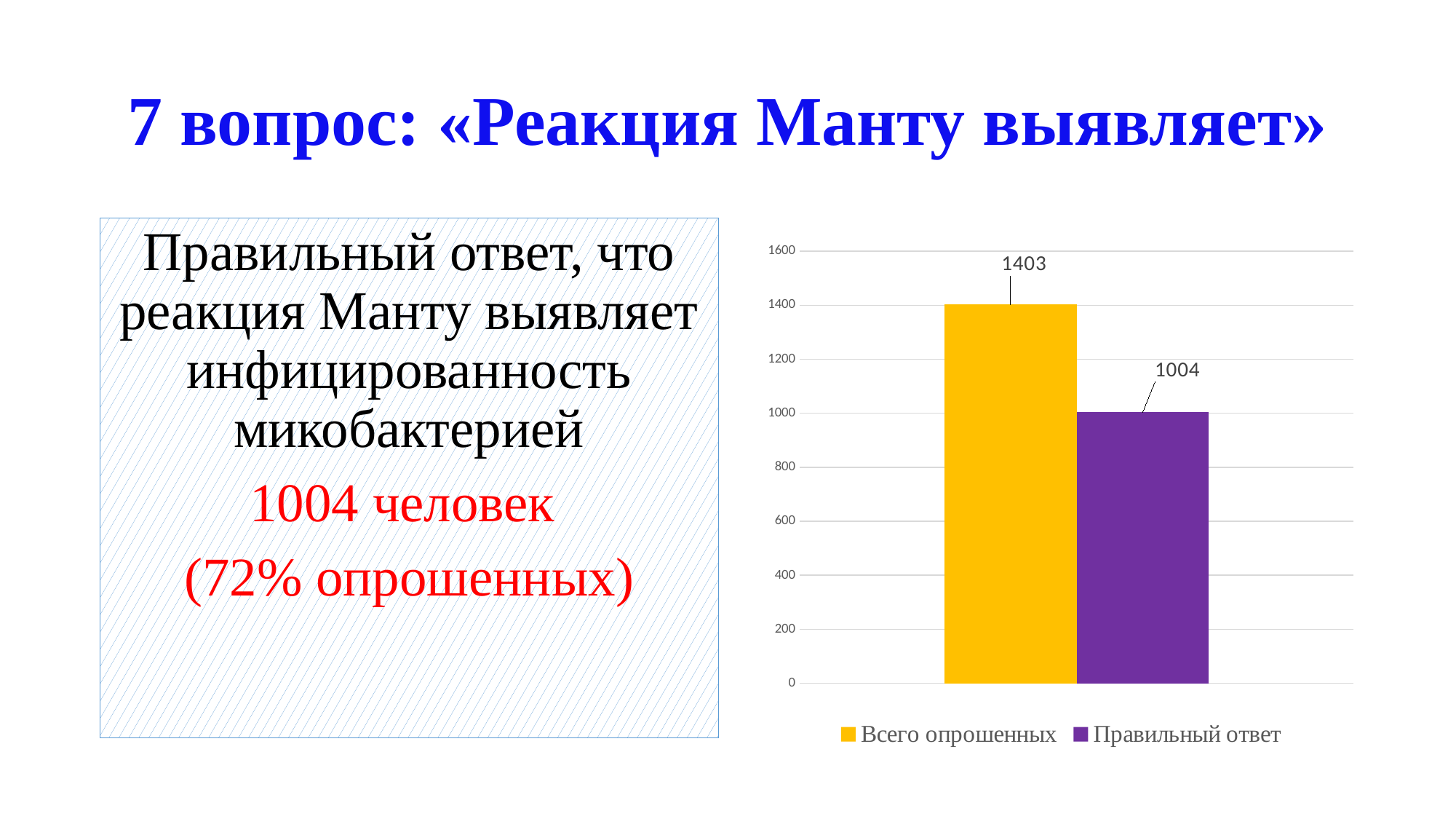
Is the value for 'Правильный ответ' greater or less than 1200? less What colour is the 'Правильный ответ' bar? purple What is the highest value shown on the vertical axis? 1600 Which series has the lowest value in the chart? Правильный ответ Is the value for 'Всего опрошенных' greater or less than 1200? greater What kind of chart is shown on the slide? bar chart How many series does the legend list? 2 Which series has the higher value, 'Всего опрошенных' or 'Правильный ответ'? Всего опрошенных What is the value of the 'Правильный ответ' bar? 1004 What is the value of the 'Всего опрошенных' bar? 1403 What is the difference between the 'Всего опрошенных' value and the 'Правильный ответ' value? 399 How many bars are plotted in the chart? 2